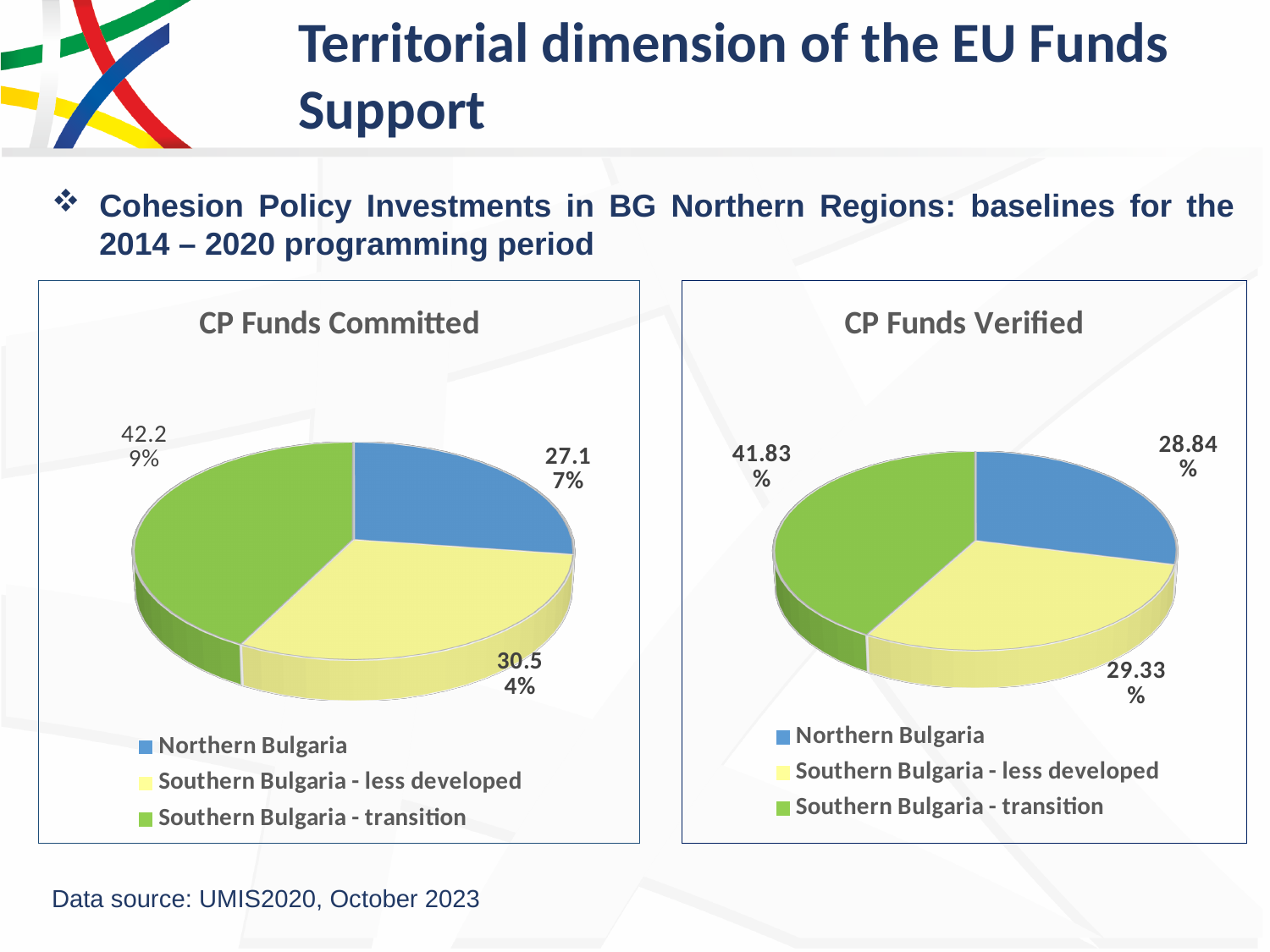
What type of chart is the CP Funds Committed chart? Pie chart In the CP Funds Committed chart, which category has the smallest slice? Northern Bulgaria In the CP Funds Verified chart, what share does Southern Bulgaria - transition have? 41.83% In the CP Funds Committed chart, what is the difference between the Southern Bulgaria - less developed share and the Northern Bulgaria share? 3.37% In the CP Funds Committed chart, what share does Northern Bulgaria have? 27.17% In the CP Funds Committed chart, what share does Southern Bulgaria - transition have? 42.29% In the CP Funds Committed chart, which category has the largest slice? Southern Bulgaria - transition In the CP Funds Verified chart, what share does Southern Bulgaria - less developed have? 29.33% In the CP Funds Verified chart, what is the difference between the Southern Bulgaria - transition share and the Northern Bulgaria share? 12.99% In the CP Funds Verified chart, which category has the largest slice? Southern Bulgaria - transition Is the Northern Bulgaria share larger in the CP Funds Committed chart or in the CP Funds Verified chart? CP Funds Verified How many slices does the CP Funds Verified pie chart have? 3